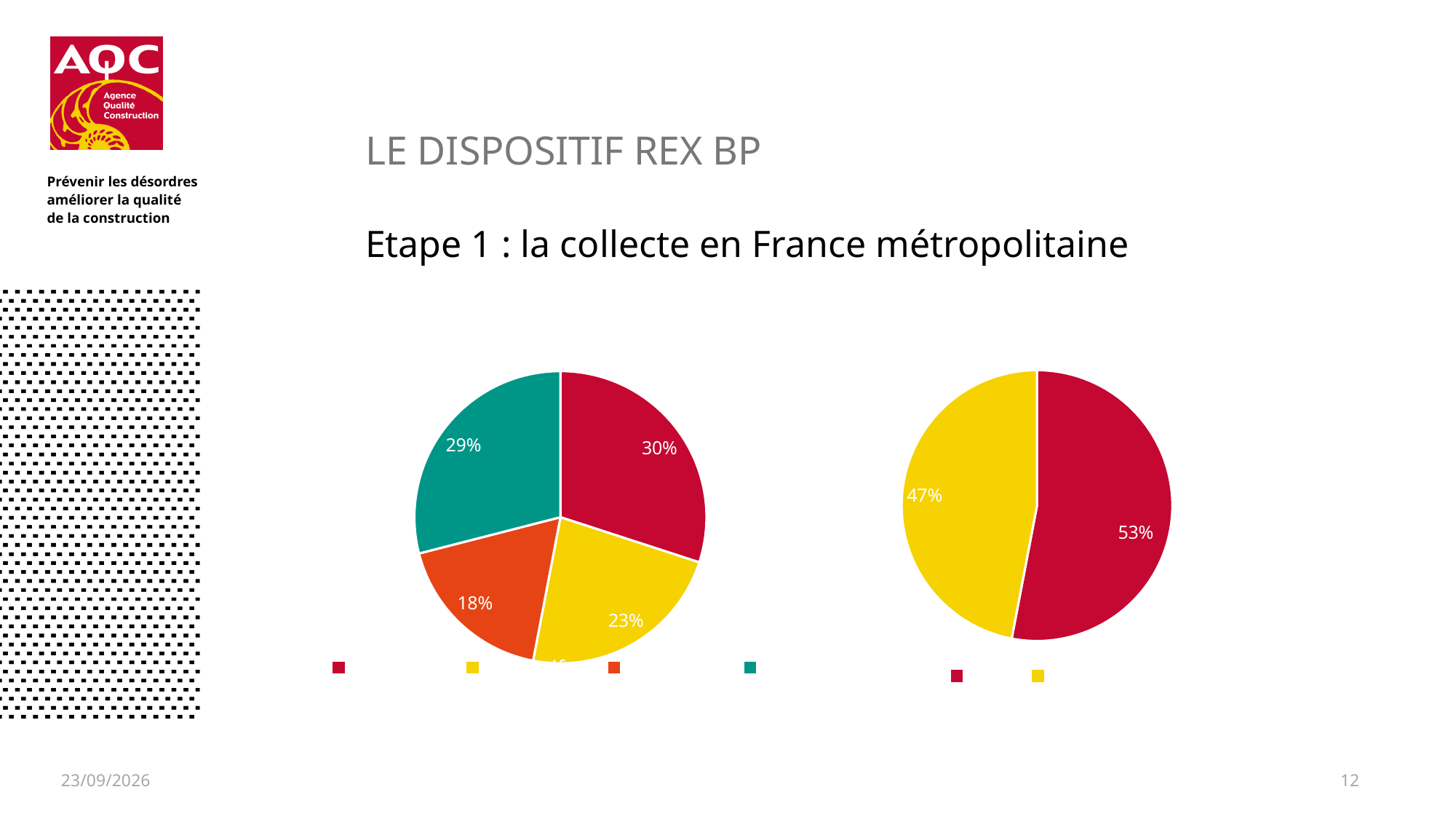
What kind of chart is the chart on the right of the slide? pie chart In the left pie chart, what percentage is shown on the teal slice? 29% What kind of chart is the chart on the left of the slide? pie chart In the left pie chart, how many slices are there? 4 In the left pie chart, what percentage is shown on the red slice? 30% In the left pie chart, what is the smallest slice's percentage? 18% In the right pie chart, what percentage is shown on the yellow slice? 47% In the right pie chart, how many slices are there? 2 In the left pie chart, what percentage is shown on the orange slice? 18% In the right pie chart, which slice is larger, the red one or the yellow one? the red one In the right pie chart, what is the difference in percentage points between the red slice and the yellow slice? 6 In the left pie chart, what is the difference in percentage points between the red slice and the yellow slice? 7